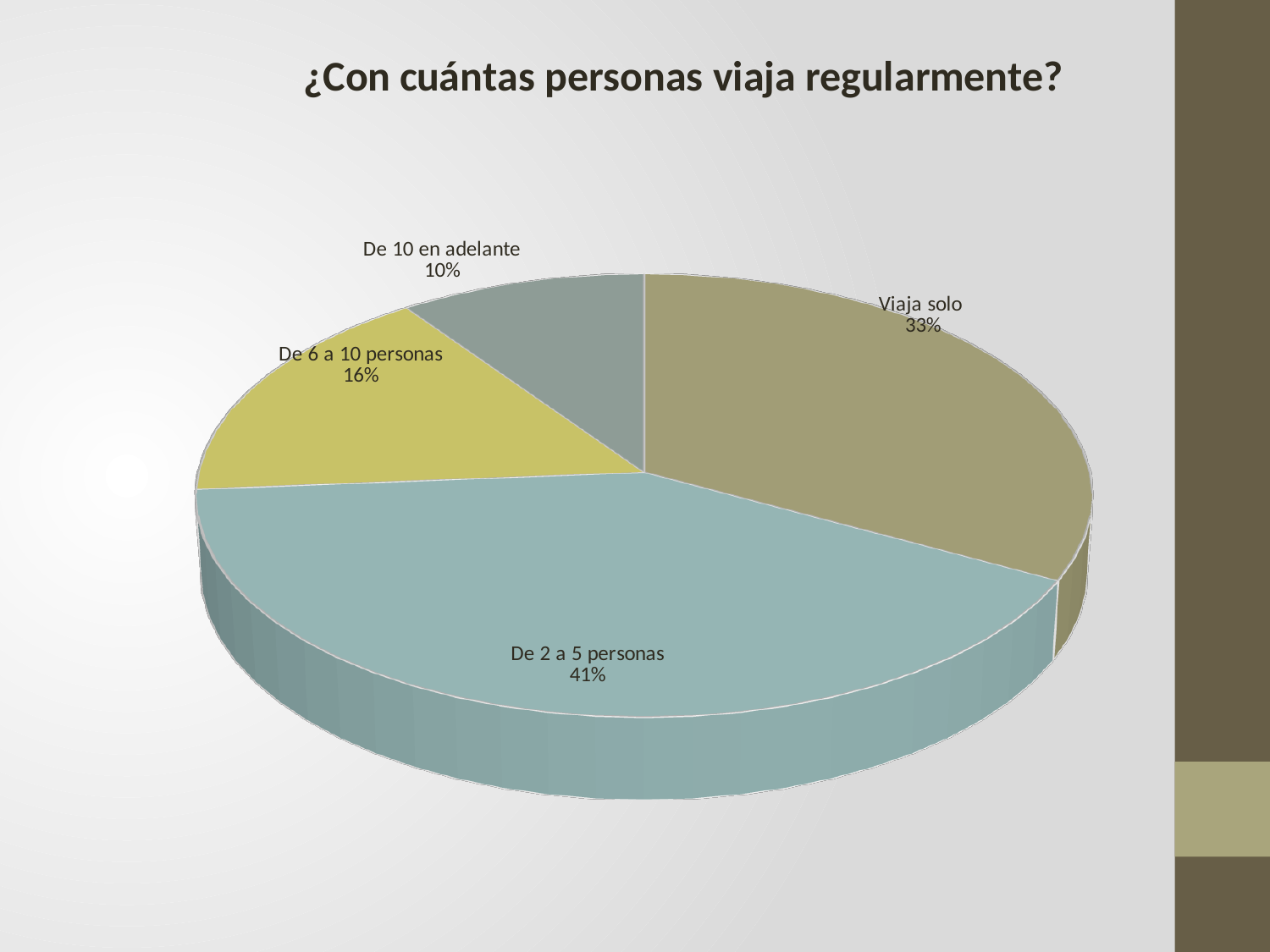
Which is larger, the slice for "Viaja solo" or the slice for "De 6 a 10 personas"? Viaja solo What is the difference in percentage points between "De 6 a 10 personas" and "De 10 en adelante"? 6 What is the value shown for "De 6 a 10 personas"? 16% What kind of chart is shown on the slide? Pie chart What is the title of the chart? ¿Con cuántas personas viaja regularmente? Which category has the largest slice of the pie? De 2 a 5 personas Which category has the smallest slice of the pie? De 10 en adelante What is the value shown for "De 10 en adelante"? 10% What share of the pie does "Viaja solo" represent? 33% What is the difference in percentage points between "De 2 a 5 personas" and "Viaja solo"? 8 What share of the pie does "De 2 a 5 personas" represent? 41% How many categories are shown in the pie chart? 4